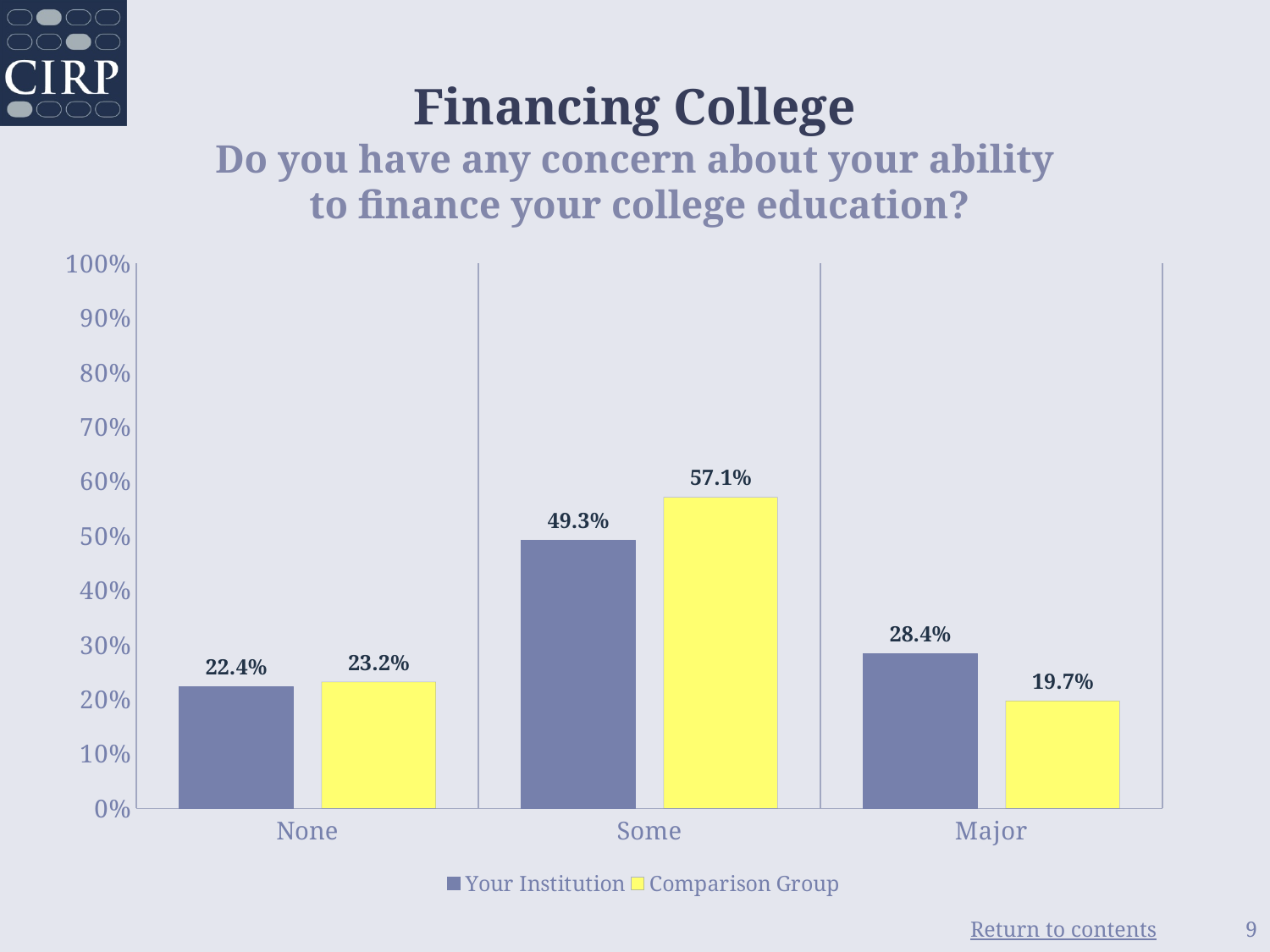
What is the value for Comparison Group in the None category? 23.2% What is the value for Your Institution in the Some category? 49.3% What colour are the Comparison Group bars? yellow Which category has the highest value for Comparison Group? Some How many series does the legend list? 2 Is the value for Your Institution in the Major category greater or less than 30%? less Which category has the lowest value for Your Institution? None How many categories are shown on the x axis? 3 What is the value for Comparison Group in the Major category? 19.7% What kind of chart is shown on the slide? bar chart What is the difference between Comparison Group and Your Institution in the Some category? 7.8% In the Major category, which series has the larger value, Your Institution or Comparison Group? Your Institution